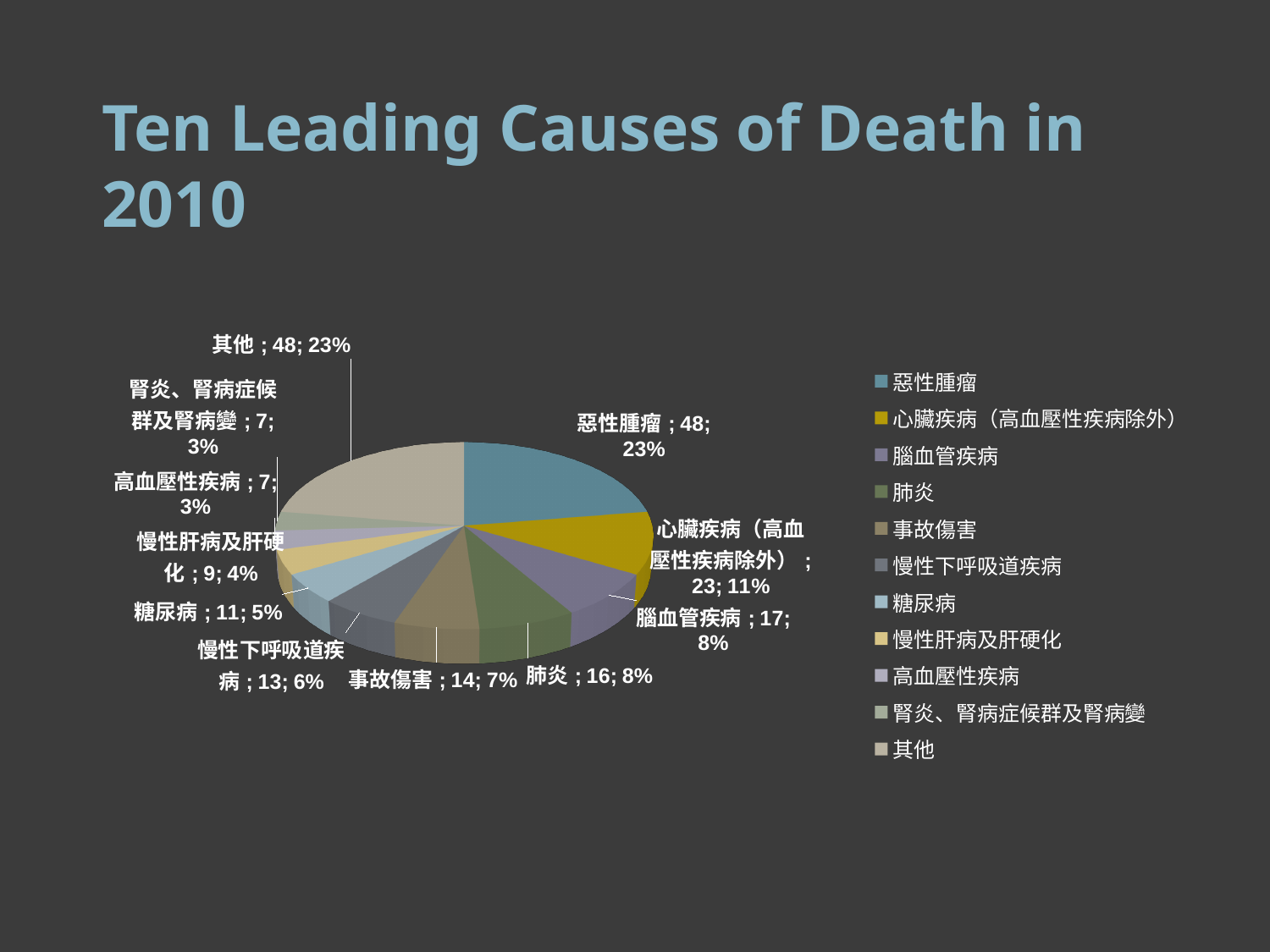
What is the difference between the value for 惡性腫瘤 and the value for 心臟疾病（高血壓性疾病除外）? 25 What percentage share does 肺炎 have in the pie chart? 8% What is the title of the slide containing the pie chart? Ten Leading Causes of Death in 2010 Which is larger, the value for 糖尿病 or the value for 慢性肝病及肝硬化? 糖尿病 What value is shown for 事故傷害? 14 What percentage share does 心臟疾病（高血壓性疾病除外） have in the pie chart? 11% Excluding 其他, which named cause of death has the largest slice in the pie chart? 惡性腫瘤 What value is shown for 惡性腫瘤 in the pie chart? 48 What percentage share does 其他 have in the pie chart? 23% What value is shown for 腦血管疾病? 17 What kind of chart is shown on the slide? Pie chart How many slices does the pie chart have? 11